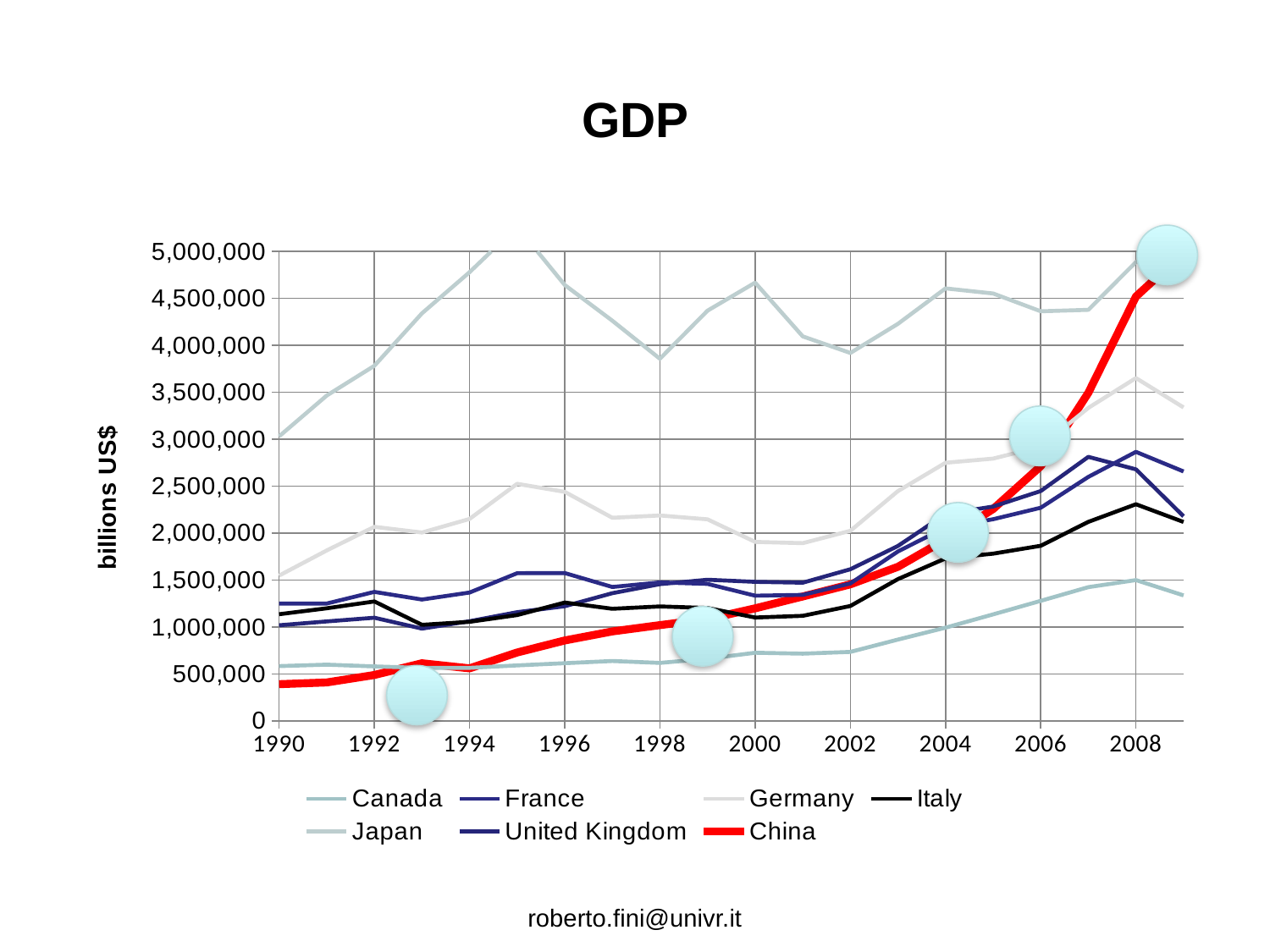
Which country has the lowest GDP in 1990? China Which country has the lowest GDP in 2008? Canada Is the value for China in 1990 greater or less than 500,000? less Is the value for Germany in 2008 greater or less than 3,000,000? greater What kind of chart is shown on the slide? line chart What is the label on the vertical axis? billions US$ How many series does the legend list? 7 What is the title of the chart? GDP Which country has the highest GDP in 1990? Japan Does the GDP of China rise or fall from 1990 to 2009? rise Is the value for China in 2008 greater or less than 4,000,000? greater Which is larger in 2008, the GDP of China or the GDP of Germany? China